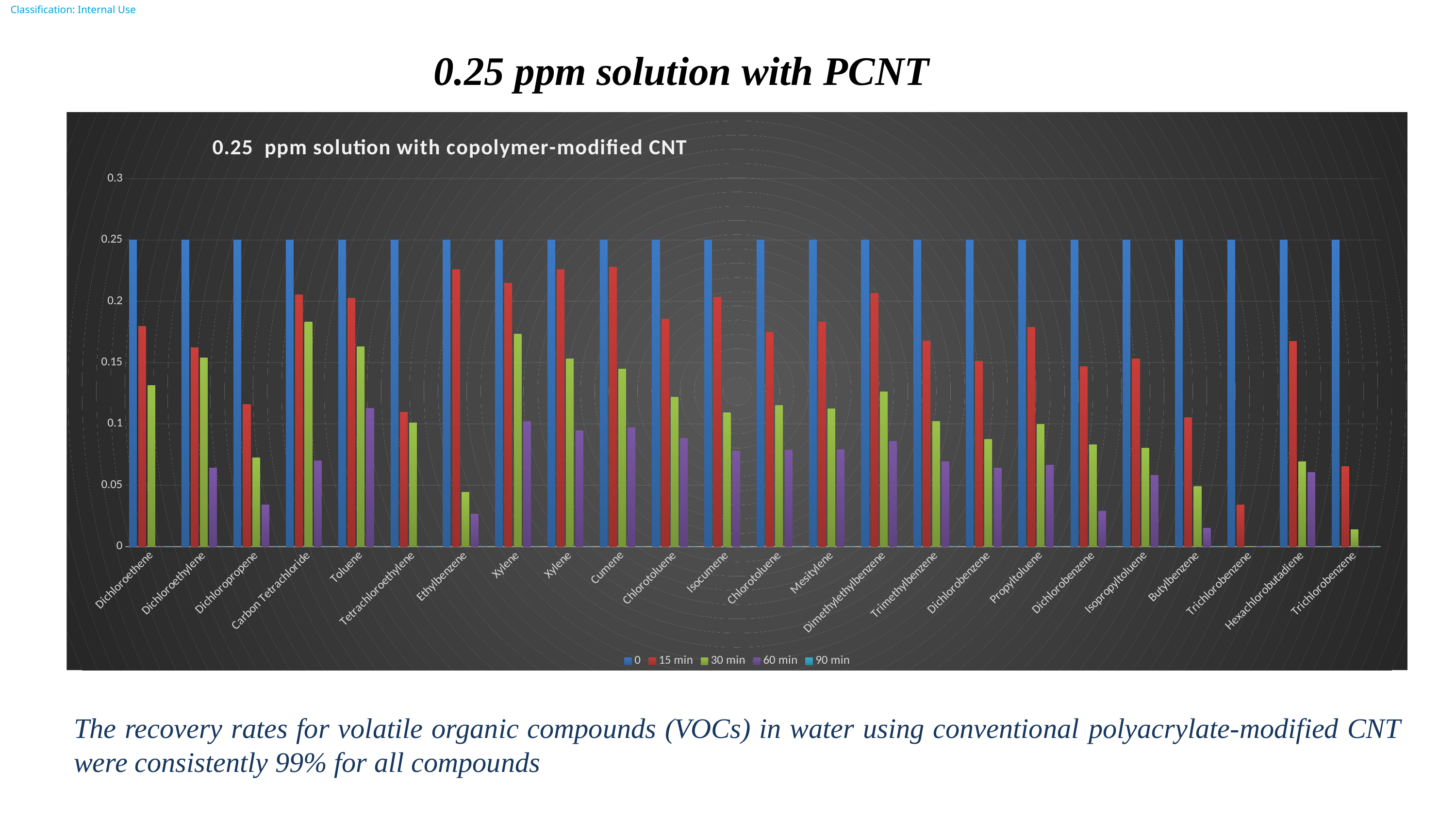
Which compound has the highest 30 min value? Carbon Tetrachloride How many compound categories are plotted along the x axis? 24 Which has the larger 15 min value, Cumene or Butylbenzene? Cumene Is the 30 min value for Ethylbenzene greater or less than 0.1? less Is the 30 min value for Carbon Tetrachloride greater or less than 0.15? greater Is the 15 min value for Ethylbenzene greater or less than 0.2? greater What is the title shown inside the chart area? 0.25 ppm solution with copolymer-modified CNT What kind of chart is shown on the slide? bar chart What is the value of the '0' series for Toluene? 0.25 How many series does the chart legend list? 5